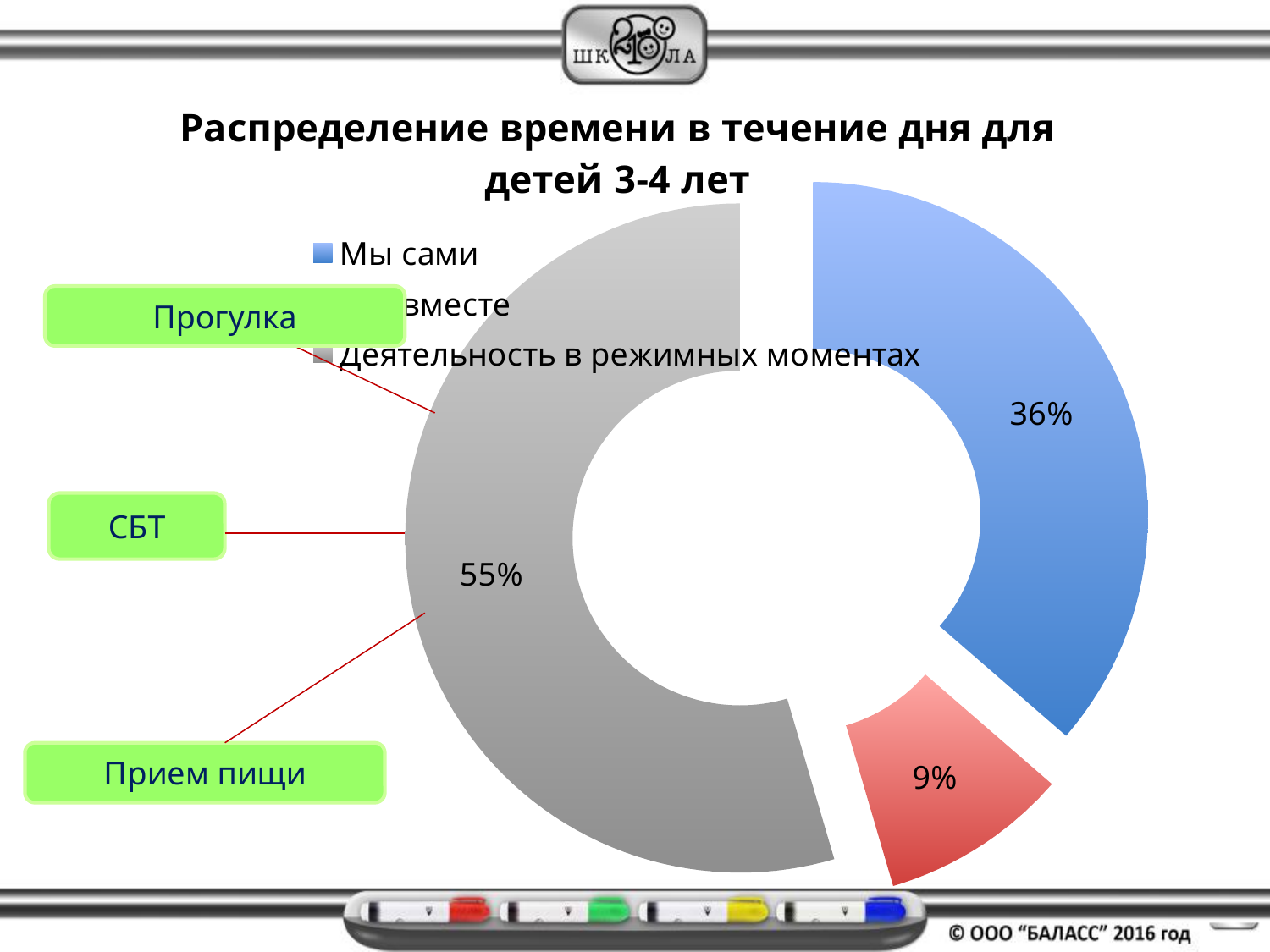
Which slice of the chart is the smallest? The red slice (9%) How many entries does the legend list? 3 What is the difference in percentage points between "Деятельность в режимных моментах" and "Мы сами"? 19 Which is larger: the share for "Мы сами" or the share on the red slice? Мы сами What percentage is shown for "Деятельность в режимных моментах"? 55% What percentage of the day is shown for "Мы сами"? 36% What is the title of the chart? Распределение времени в течение дня для детей 3-4 лет How many slices does the chart have? 3 What percentage is shown on the red slice of the chart? 9% What colour is the slice for "Мы сами"? Blue What type of chart is shown on the slide? Doughnut (pie) chart Which category has the largest share of the day? Деятельность в режимных моментах